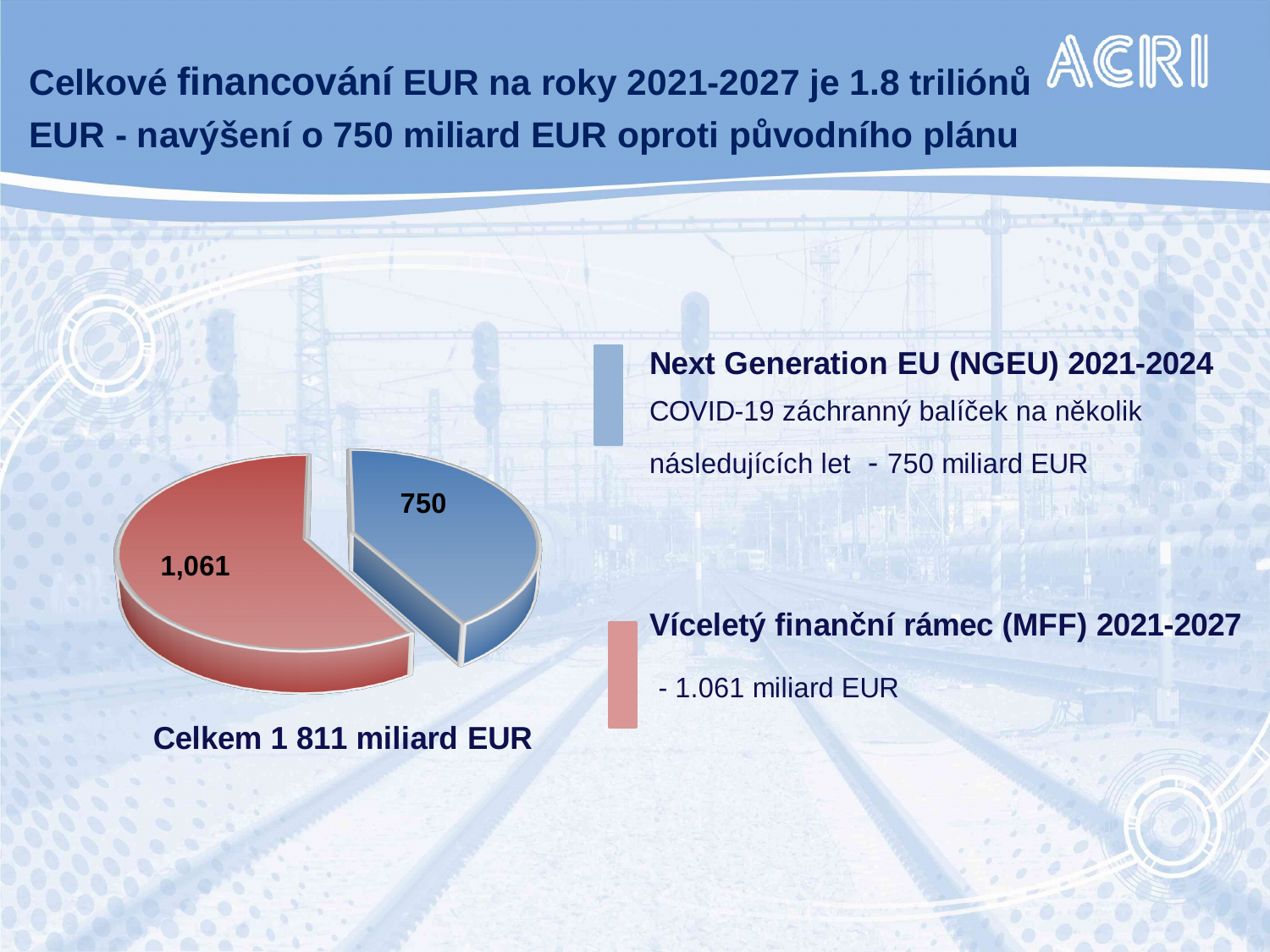
How many slices does the pie chart have? 2 Which colour represents Next Generation EU (NGEU) 2021-2024 in the pie chart? blue What kind of chart is shown on the slide? pie chart What total is stated below the pie chart? Celkem 1 811 miliard EUR What value is labelled on the blue slice of the pie chart? 750 Which slice of the pie chart is the smallest? 750 (Next Generation EU (NGEU) 2021-2024) What is the value for Víceletý finanční rámec (MFF) 2021-2027 in the pie chart? 1,061 Which slice of the pie chart is the largest? 1,061 (Víceletý finanční rámec (MFF) 2021-2027) Which is larger in the pie chart: the MFF slice or the NGEU slice? the MFF slice (1,061) What is the value for Next Generation EU (NGEU) 2021-2024 in the pie chart? 750 What is the difference between the two slices of the pie chart, 1,061 and 750? 311 What value is labelled on the red slice of the pie chart? 1,061